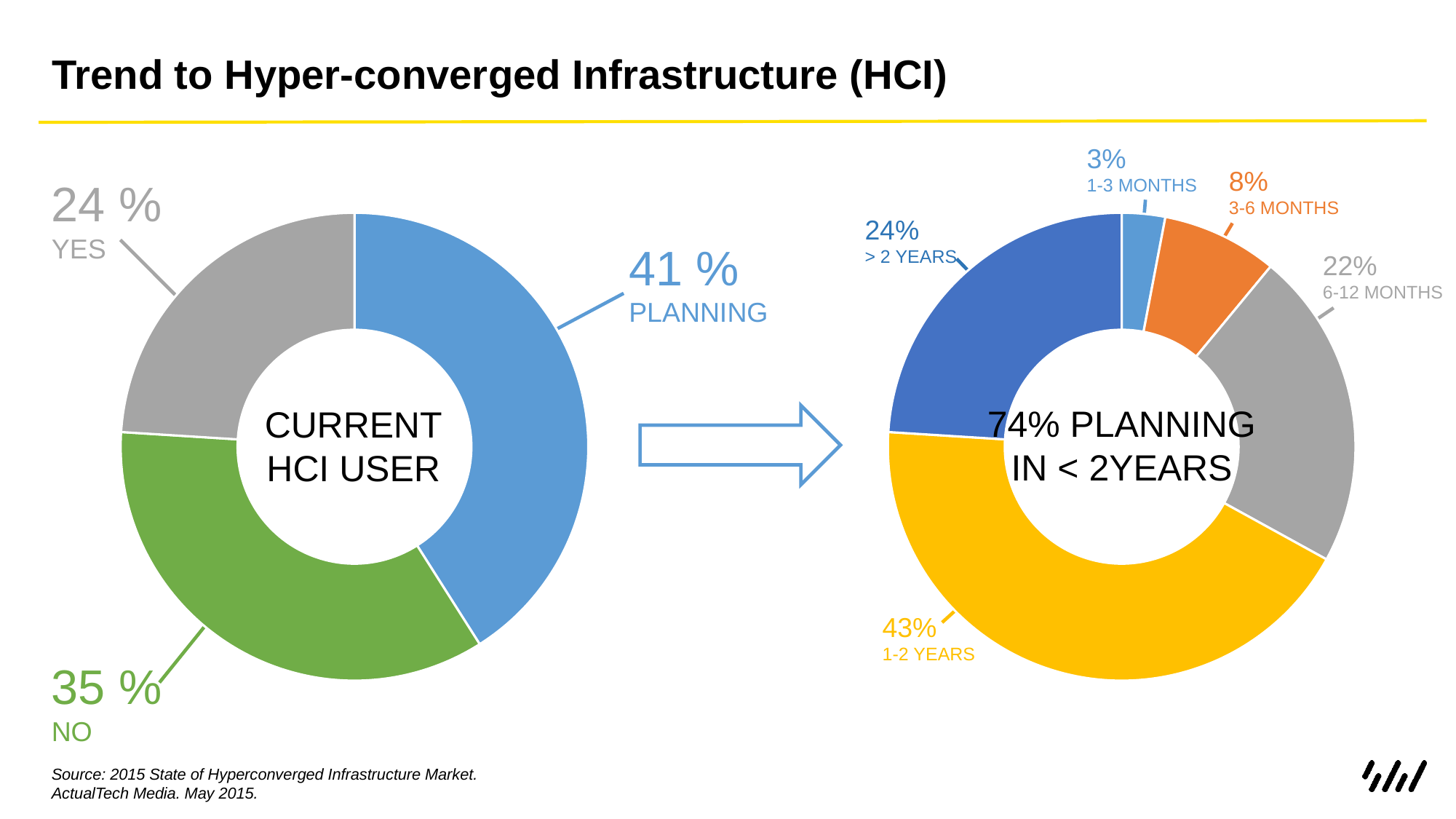
In the right chart (74% PLANNING IN < 2YEARS), what share is labelled 6-12 MONTHS? 22% How many categories does the right chart (74% PLANNING IN < 2YEARS) show? 5 In the right chart (74% PLANNING IN < 2YEARS), what share is labelled 1-2 YEARS? 43% In the right chart (74% PLANNING IN < 2YEARS), which category has the smallest share? 1-3 MONTHS In the left chart (CURRENT HCI USER), which category has the smallest share? YES In the left chart (CURRENT HCI USER), which category has the largest share? PLANNING In the right chart (74% PLANNING IN < 2YEARS), which is larger: 3-6 MONTHS or > 2 YEARS? > 2 YEARS In the left chart (CURRENT HCI USER), what share is labelled PLANNING? 41 % In the left chart (CURRENT HCI USER), what share is labelled NO? 35 % In the left chart (CURRENT HCI USER), what is the difference in percentage points between PLANNING and NO? 6 In the left chart (CURRENT HCI USER), what share is labelled YES? 24 % What kind of chart is the left chart (CURRENT HCI USER)? Doughnut (pie) chart